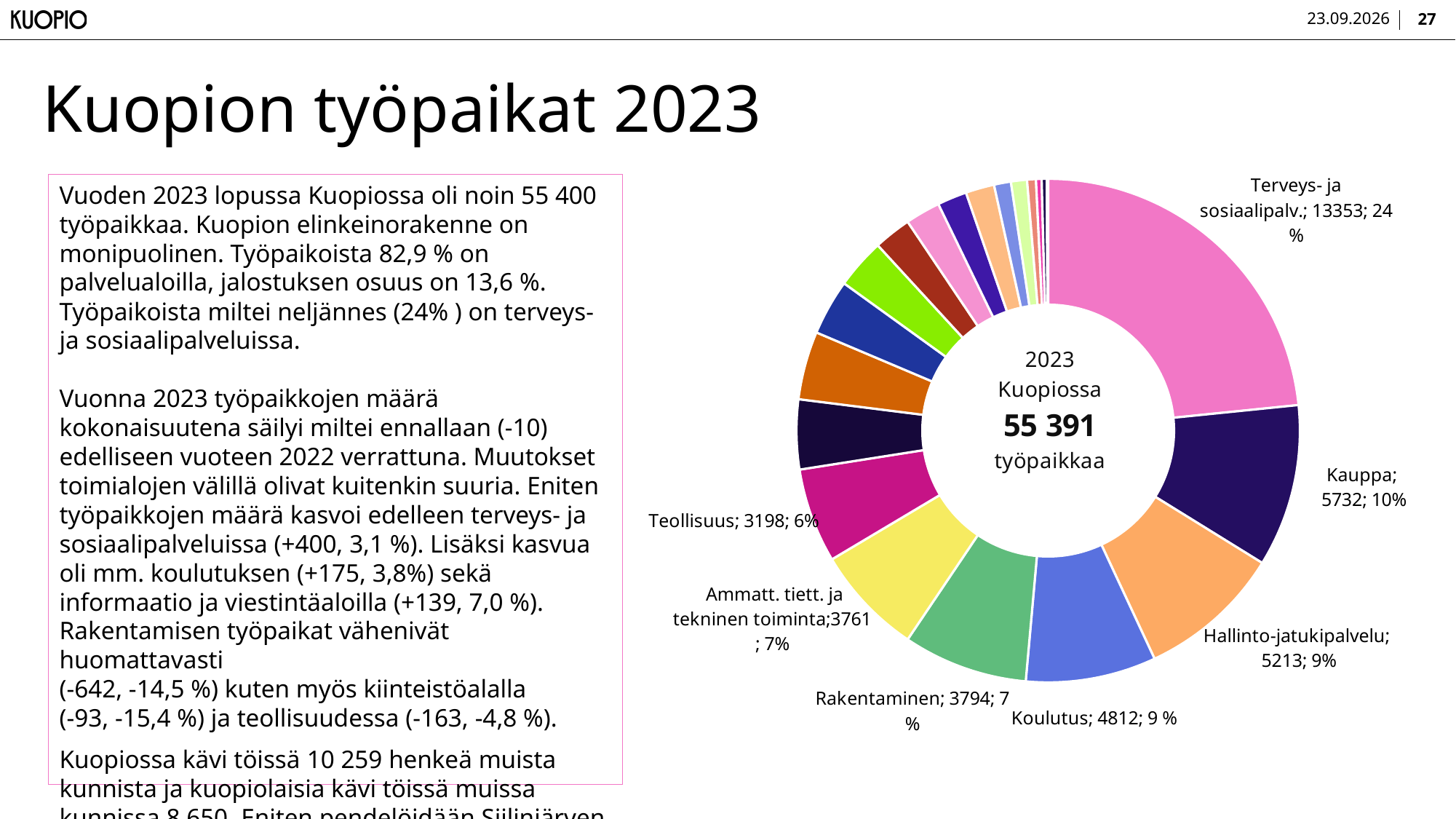
What is the value shown for Kauppa? 5732 What total number of jobs is shown in the centre of the chart? 55 391 What share of the jobs does the Terveys- ja sosiaalipalv. slice represent? 24 % What kind of chart is shown on the slide? doughnut chart What is the difference between the values for Rakentaminen and Ammatt. tiett. ja tekninen toiminta? 33 What is the value shown for Teollisuus? 3198 What is the value shown for Koulutus? 4812 Which has a larger value, Koulutus or Rakentaminen? Koulutus Which sector has the largest slice in the chart? Terveys- ja sosiaalipalv. What is the difference between the values for Kauppa and Hallinto-ja tukipalvelu? 519 How many jobs does the chart show for Terveys- ja sosiaalipalv.? 13353 What percentage share is shown for Kauppa? 10%